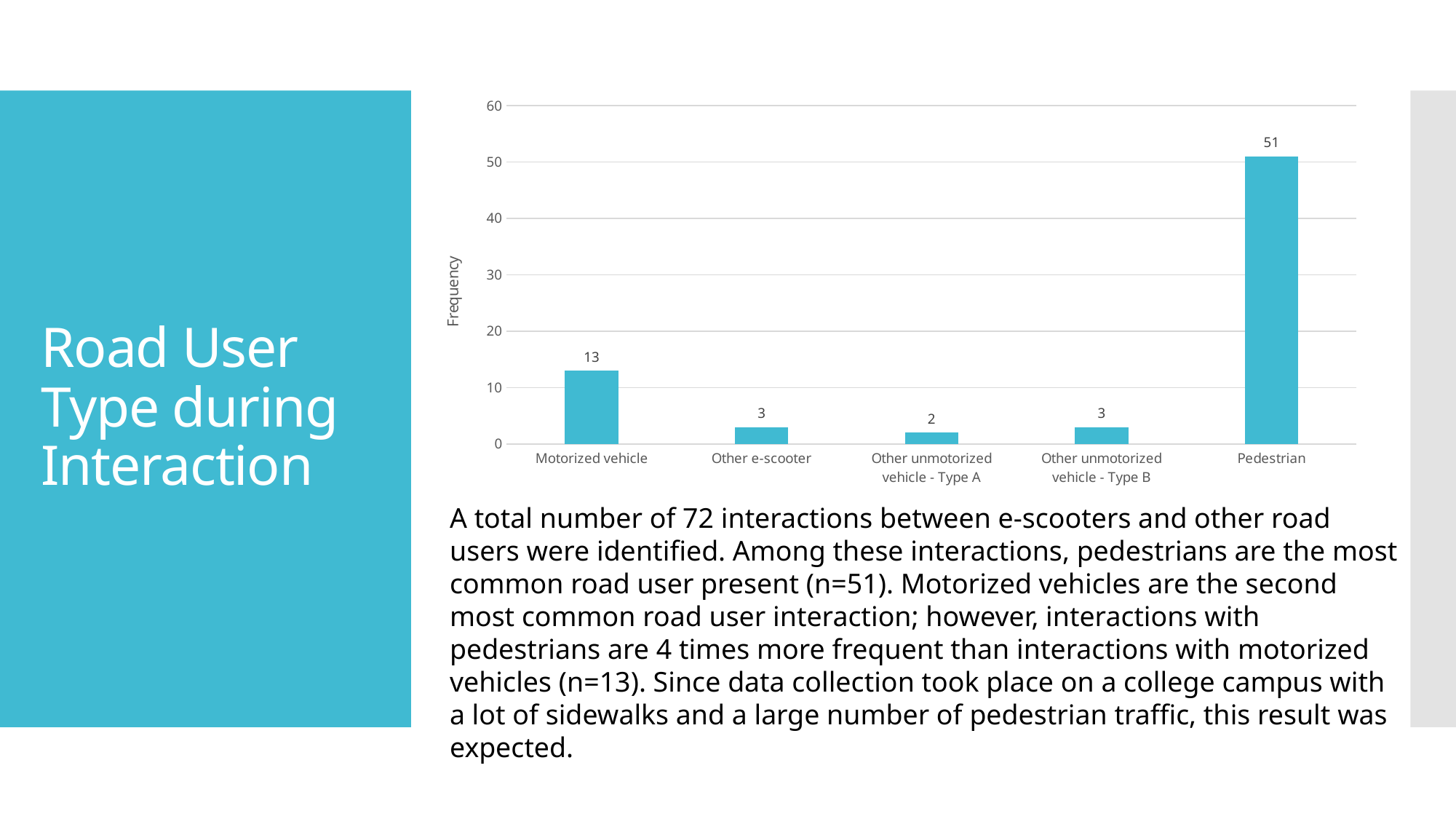
What is the frequency for Pedestrian? 51 What is the difference in frequency between Pedestrian and Motorized vehicle? 38 What kind of chart is shown on the slide? Bar chart Which road user type has the highest frequency? Pedestrian Which has a higher frequency, Motorized vehicle or Other e-scooter? Motorized vehicle How many road user type categories are shown on the chart? 5 What is the frequency for Other e-scooter? 3 What is the frequency for Motorized vehicle? 13 Is the value for Pedestrian greater or less than 40? greater What is the label of the vertical axis? Frequency Which road user type has the lowest frequency? Other unmotorized vehicle - Type A What is the frequency for Other unmotorized vehicle - Type A? 2